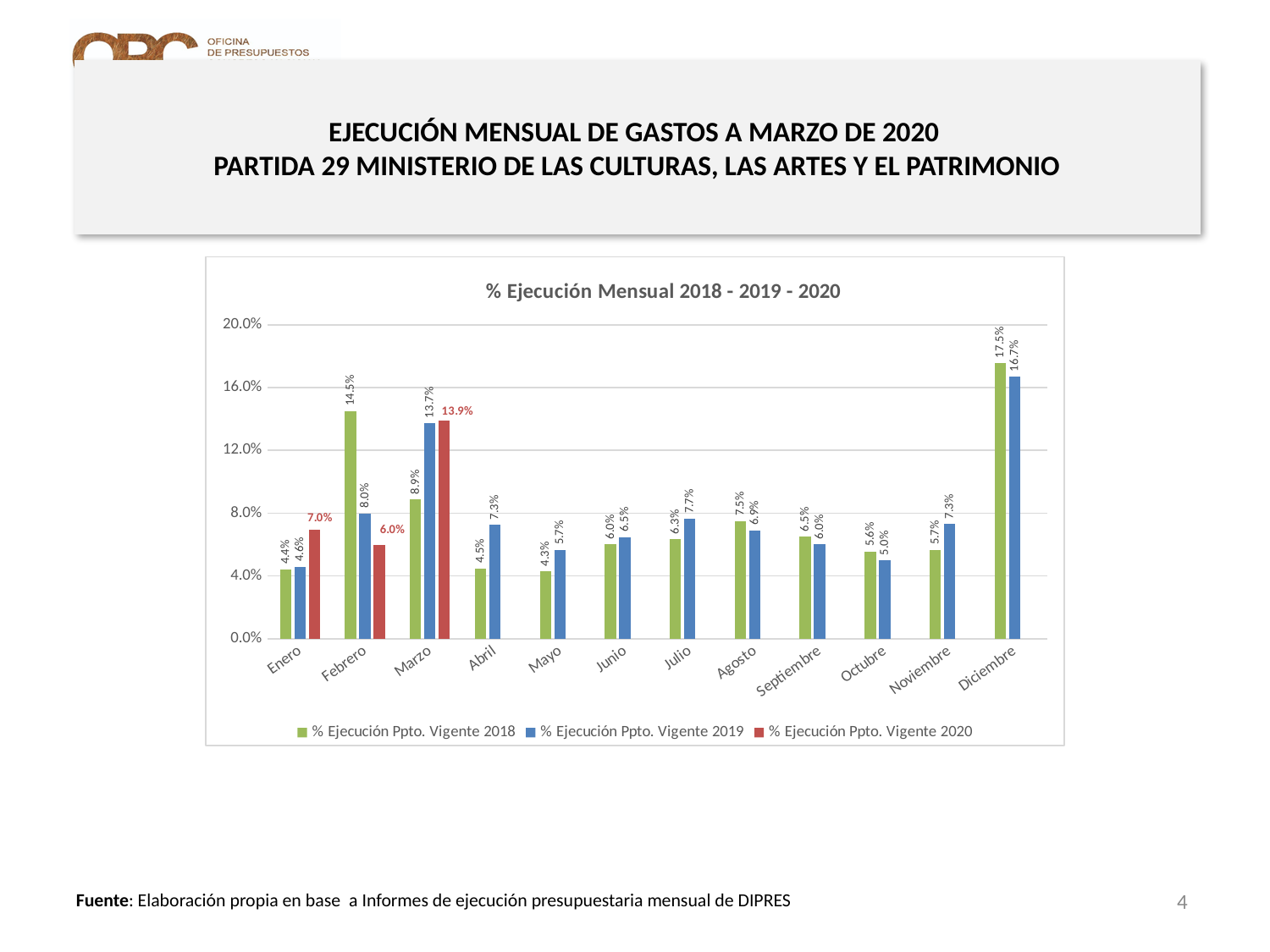
Is the value for % Ejecución Ppto. Vigente 2018 in Diciembre greater or less than 16.0%? greater What kind of chart is shown on the slide? Bar chart What is the title of the chart? % Ejecución Mensual 2018 - 2019 - 2020 Which is larger in Marzo: the 2019 value or the 2020 value? 2020 (13.9%) What is the value for % Ejecución Ppto. Vigente 2018 in Febrero? 14.5% How many series does the legend list? 3 Which month has the lowest value for % Ejecución Ppto. Vigente 2019? Enero What is the difference between the 2018 and 2019 values in Febrero? 6.5% How many months are shown on the x axis? 12 What is the value for % Ejecución Ppto. Vigente 2019 in Marzo? 13.7% What is the value for % Ejecución Ppto. Vigente 2020 in Enero? 7.0% Which month has the highest value for % Ejecución Ppto. Vigente 2018? Diciembre